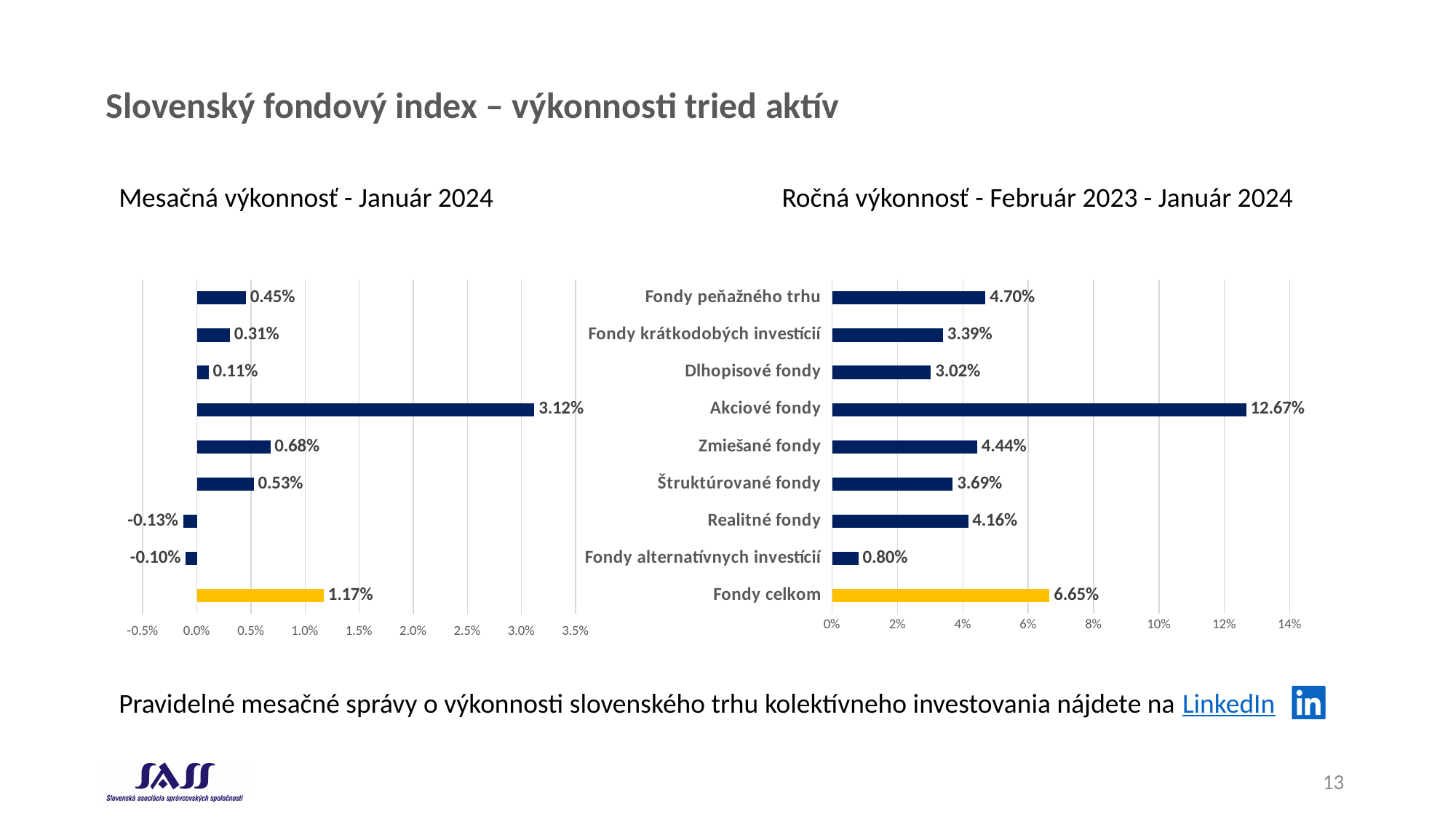
In the chart titled 'Ročná výkonnosť - Február 2023 - Január 2024', which category has the lowest value? Fondy alternatívnych investícií In the chart titled 'Ročná výkonnosť - Február 2023 - Január 2024', what is the value for Fondy celkom? 6.65% In the chart titled 'Mesačná výkonnosť - Január 2024', what is the highest value shown? 3.12% In the chart titled 'Ročná výkonnosť - Február 2023 - Január 2024', what is the difference between Fondy peňažného trhu and Dlhopisové fondy? 1.68% In the chart titled 'Mesačná výkonnosť - Január 2024', what is the lowest value shown? -0.13% In the chart titled 'Ročná výkonnosť - Február 2023 - Január 2024', which category has the highest value? Akciové fondy In the chart titled 'Ročná výkonnosť - Február 2023 - Január 2024', what is the value for Realitné fondy? 4.16% In the chart titled 'Ročná výkonnosť - Február 2023 - Január 2024', how many categories are shown? 9 In the chart titled 'Ročná výkonnosť - Február 2023 - Január 2024', what is the value for Akciové fondy? 12.67% In the chart titled 'Mesačná výkonnosť - Január 2024', how many bars have negative values? 2 What type of chart is the chart titled 'Mesačná výkonnosť - Január 2024'? Bar chart In the chart titled 'Ročná výkonnosť - Február 2023 - Január 2024', which is larger: Zmiešané fondy or Štruktúrované fondy? Zmiešané fondy